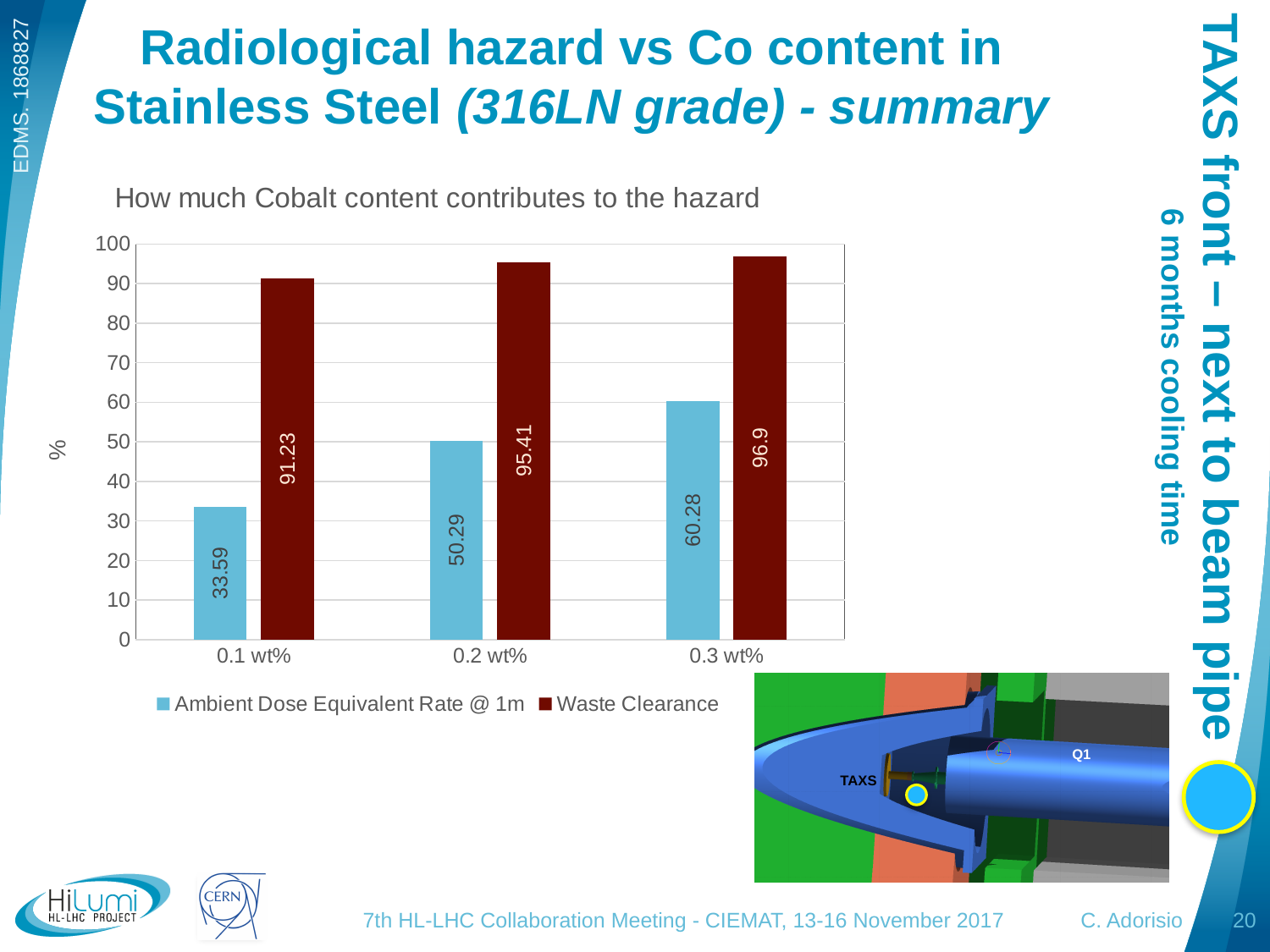
What is the Waste Clearance value for 0.3 wt%? 96.9 How many categories are shown on the x axis? 3 Do the Ambient Dose Equivalent Rate @ 1m values rise or fall from 0.1 wt% to 0.3 wt%? Rise How many series does the legend list? 2 Is the Ambient Dose Equivalent Rate @ 1m value for 0.3 wt% greater or less than 50? greater What is the Waste Clearance value for 0.2 wt%? 95.41 Which category has the lowest Waste Clearance value? 0.1 wt% What is the difference between the Waste Clearance and Ambient Dose Equivalent Rate @ 1m values for 0.1 wt%? 57.64 Which category has the highest Ambient Dose Equivalent Rate @ 1m value? 0.3 wt% What is the Ambient Dose Equivalent Rate @ 1m value for 0.1 wt%? 33.59 Which is larger for 0.2 wt%: Ambient Dose Equivalent Rate @ 1m or Waste Clearance? Waste Clearance What kind of chart is shown on the slide? Bar chart